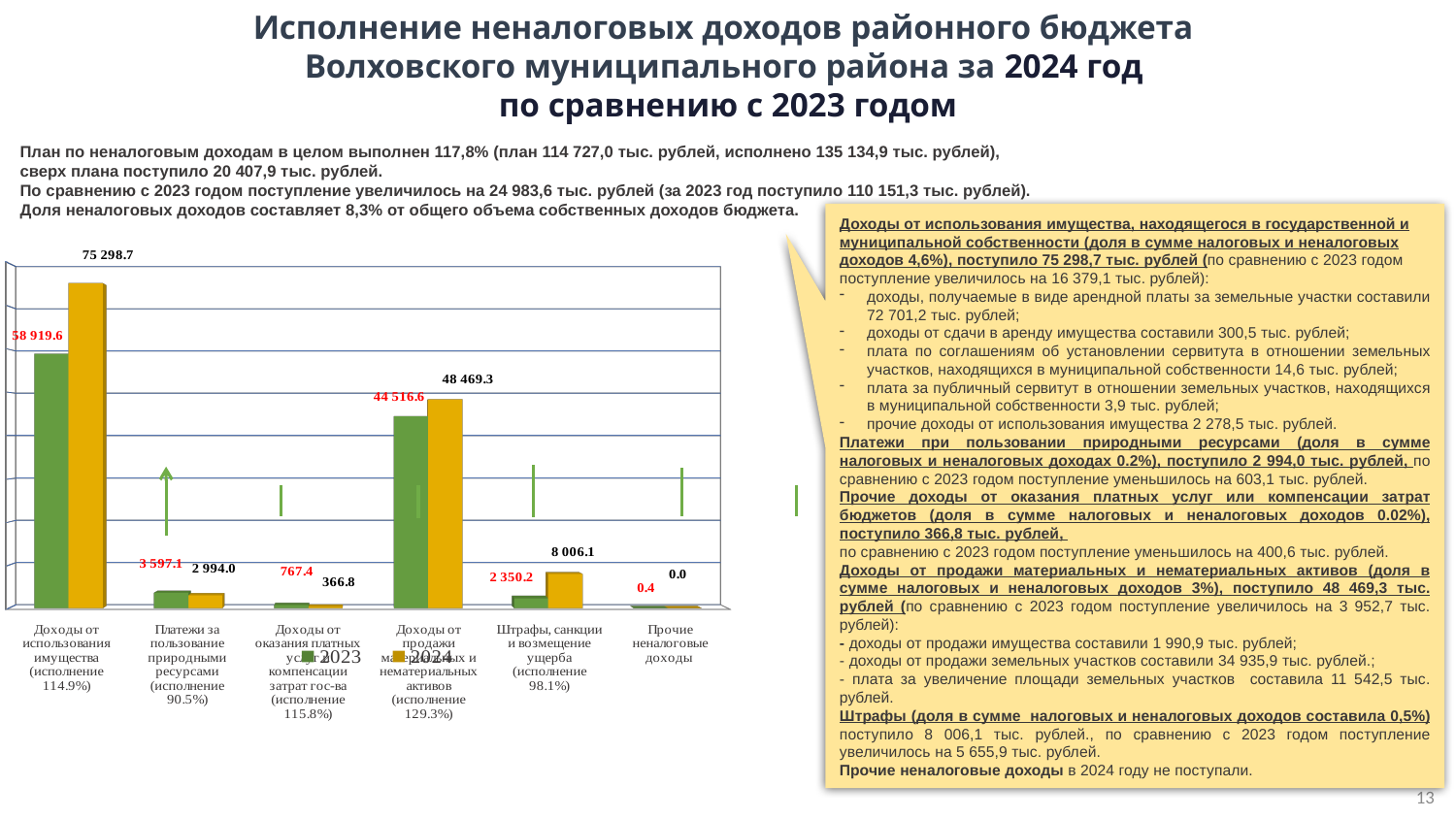
What is the 2023 value for «Доходы от использования имущества»? 58 919.6 What is the difference between the 2024 and 2023 values for «Штрафы, санкции и возмещение ущерба»? 5 655.9 What is the 2024 value for «Доходы от использования имущества»? 75 298.7 What is the 2024 value for «Штрафы, санкции и возмещение ущерба»? 8 006.1 How many categories are shown on the x axis of the chart? 6 What is the 2023 value for «Платежи за пользование природными ресурсами»? 3 597.1 What kind of chart is shown on the slide? Bar chart What is the difference between the 2024 and 2023 values for «Доходы от использования имущества»? 16 379.1 Which category has the highest 2024 value? Доходы от использования имущества Which category has the lowest 2024 value? Прочие неналоговые доходы For «Доходы от оказания платных услуг», which year has the larger value, 2023 or 2024? 2023 How many series does the chart legend list? 2